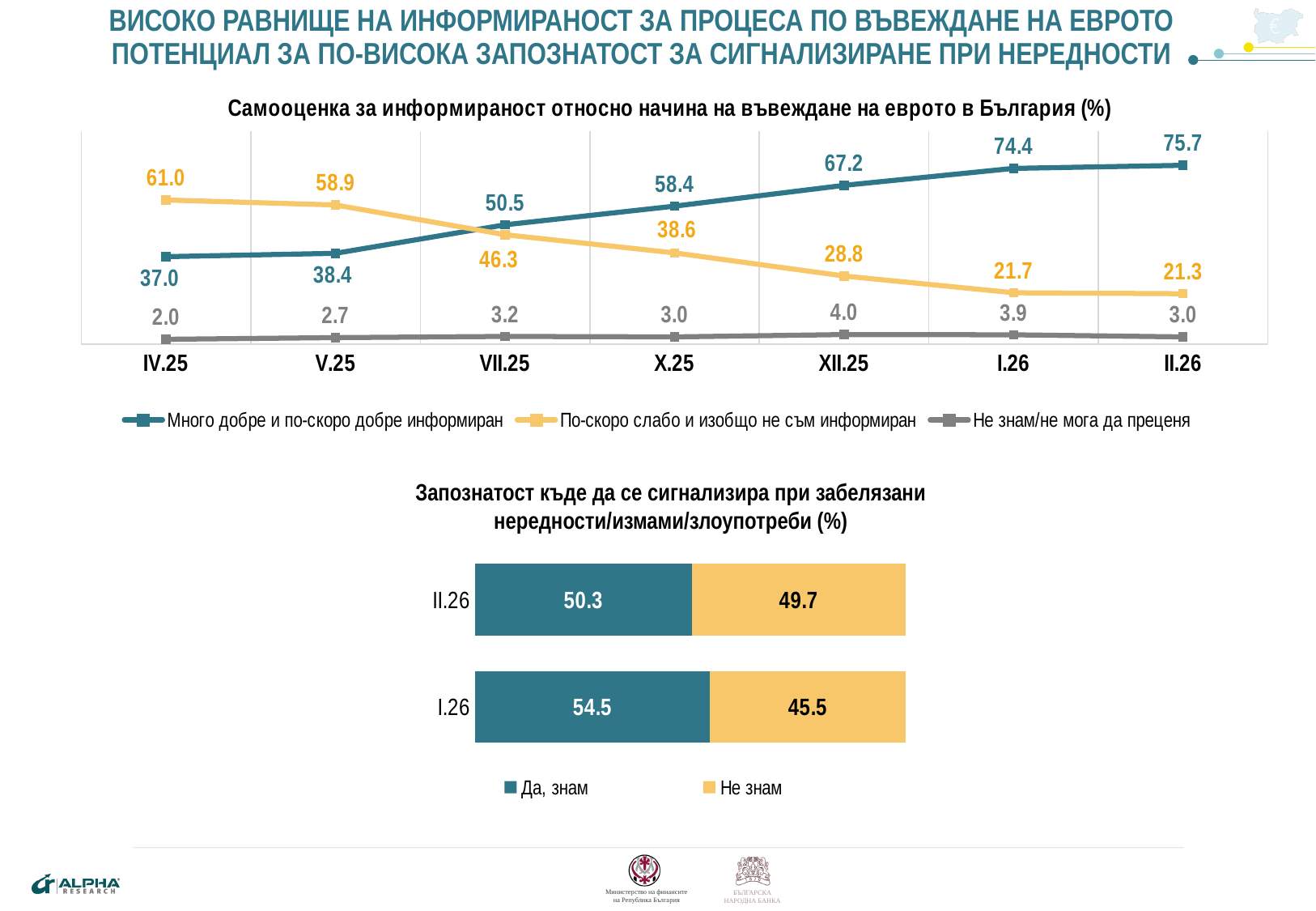
In the top chart (Самооценка за информираност относно начина на въвеждане на еврото в България), what is the value for 'Много добре и по-скоро добре информиран' at II.26? 75.7 In the top chart, what is the value for 'Не знам/не мога да преценя' at XII.25? 4.0 In the top chart, at which time point is the 'По-скоро слабо и изобщо не съм информиран' series lowest? II.26 In the top chart, at which time point is the 'Много добре и по-скоро добре информиран' series highest? II.26 What kind of chart is the bottom chart (Запознатост къде да се сигнализира при забелязани нередности/измами/злоупотреби)? stacked bar chart In the top chart, how many time points are shown on the x axis? 7 In the top chart, which is larger at V.25: 'Много добре и по-скоро добре информиран' or 'По-скоро слабо и изобщо не съм информиран'? По-скоро слабо и изобщо не съм информиран In the top chart, does the 'По-скоро слабо и изобщо не съм информиран' series rise or fall from IV.25 to II.26? fall In the bottom chart (Запознатост къде да се сигнализира при забелязани нередности/измами/злоупотреби), what is the value for 'Да, знам' at I.26? 54.5 In the top chart, how many series does the legend list? 3 In the top chart, what is the difference between the 'Много добре и по-скоро добре информиран' values at II.26 and IV.25? 38.7 In the top chart, what is the value for 'По-скоро слабо и изобщо не съм информиран' at IV.25? 61.0